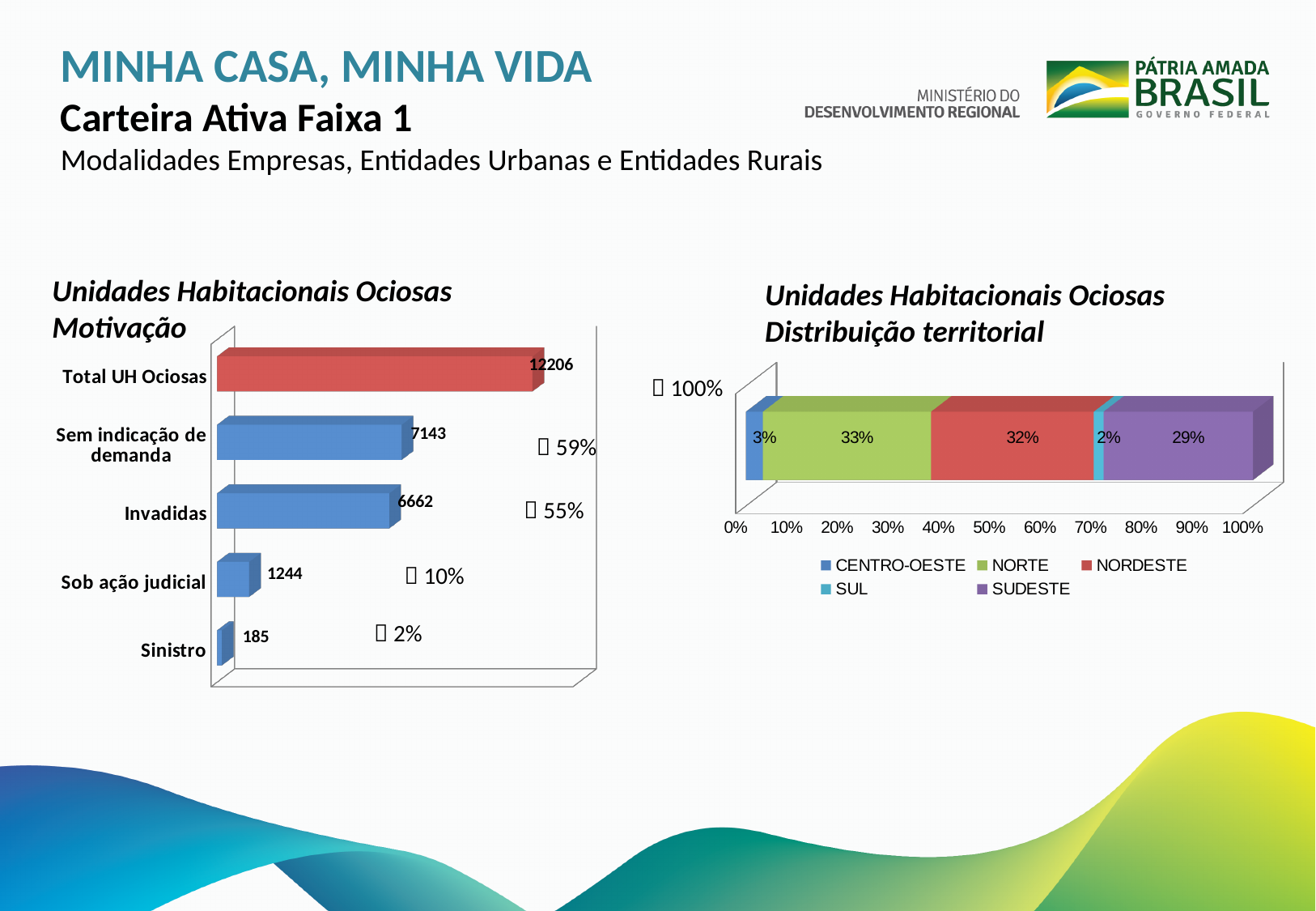
In the 'Unidades Habitacionais Ociosas Motivação' chart, which is larger: Sob ação judicial or Sinistro? Sob ação judicial In the 'Unidades Habitacionais Ociosas Motivação' chart, what is the value for Total UH Ociosas? 12206 How many series does the legend of the 'Unidades Habitacionais Ociosas Distribuição territorial' chart list? 5 In the 'Unidades Habitacionais Ociosas Distribuição territorial' chart, which region has the highest share? NORTE In the 'Unidades Habitacionais Ociosas Motivação' chart, what is the value for Invadidas? 6662 How many categories are shown in the 'Unidades Habitacionais Ociosas Motivação' chart? 5 In the 'Unidades Habitacionais Ociosas Distribuição territorial' chart, what is the share for NORDESTE? 32% In the 'Unidades Habitacionais Ociosas Motivação' chart, what is the difference between Sem indicação de demanda and Invadidas? 481 In the 'Unidades Habitacionais Ociosas Motivação' chart, which category has the lowest value? Sinistro In the 'Unidades Habitacionais Ociosas Motivação' chart, what is the value for Sob ação judicial? 1244 In the 'Unidades Habitacionais Ociosas Distribuição territorial' chart, what is the difference between NORTE and SUDESTE? 4% What kind of chart is 'Unidades Habitacionais Ociosas Motivação'? Bar chart